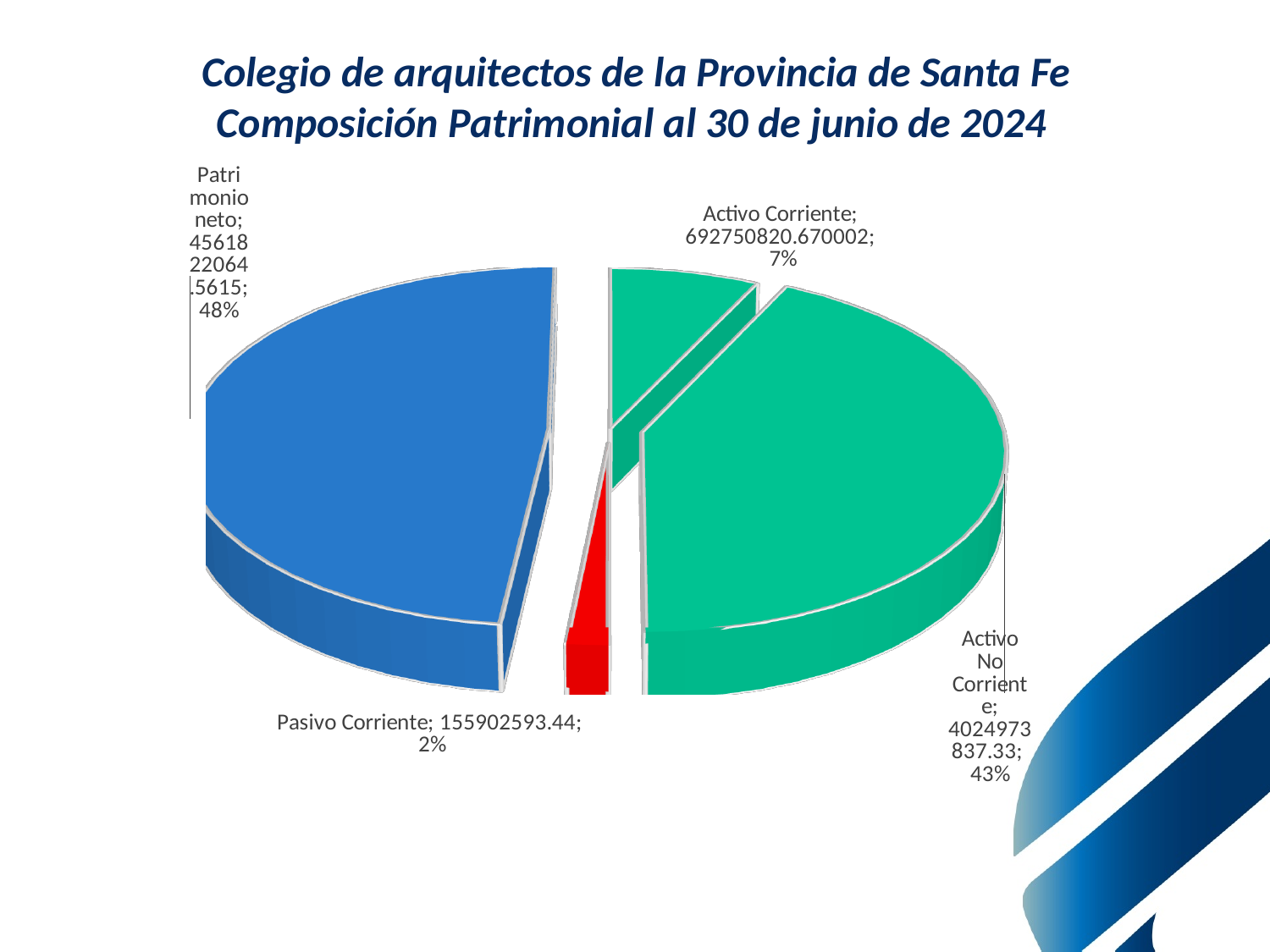
Which category has the smallest slice of the pie? Pasivo Corriente What kind of chart is shown on the slide? Pie chart What share of the pie does Patrimonio neto represent? 48% What share of the pie does Activo Corriente represent? 7% What is the value shown for Pasivo Corriente? 155902593.44 How many slices does the pie chart have? 4 What share of the pie does Pasivo Corriente represent? 2% What is the value shown for Activo No Corriente? 4024973837.33 Which is larger, the share for Activo Corriente or the share for Pasivo Corriente? Activo Corriente Which category has the largest slice of the pie? Patrimonio neto What is the value shown for Activo Corriente? 692750820.670002